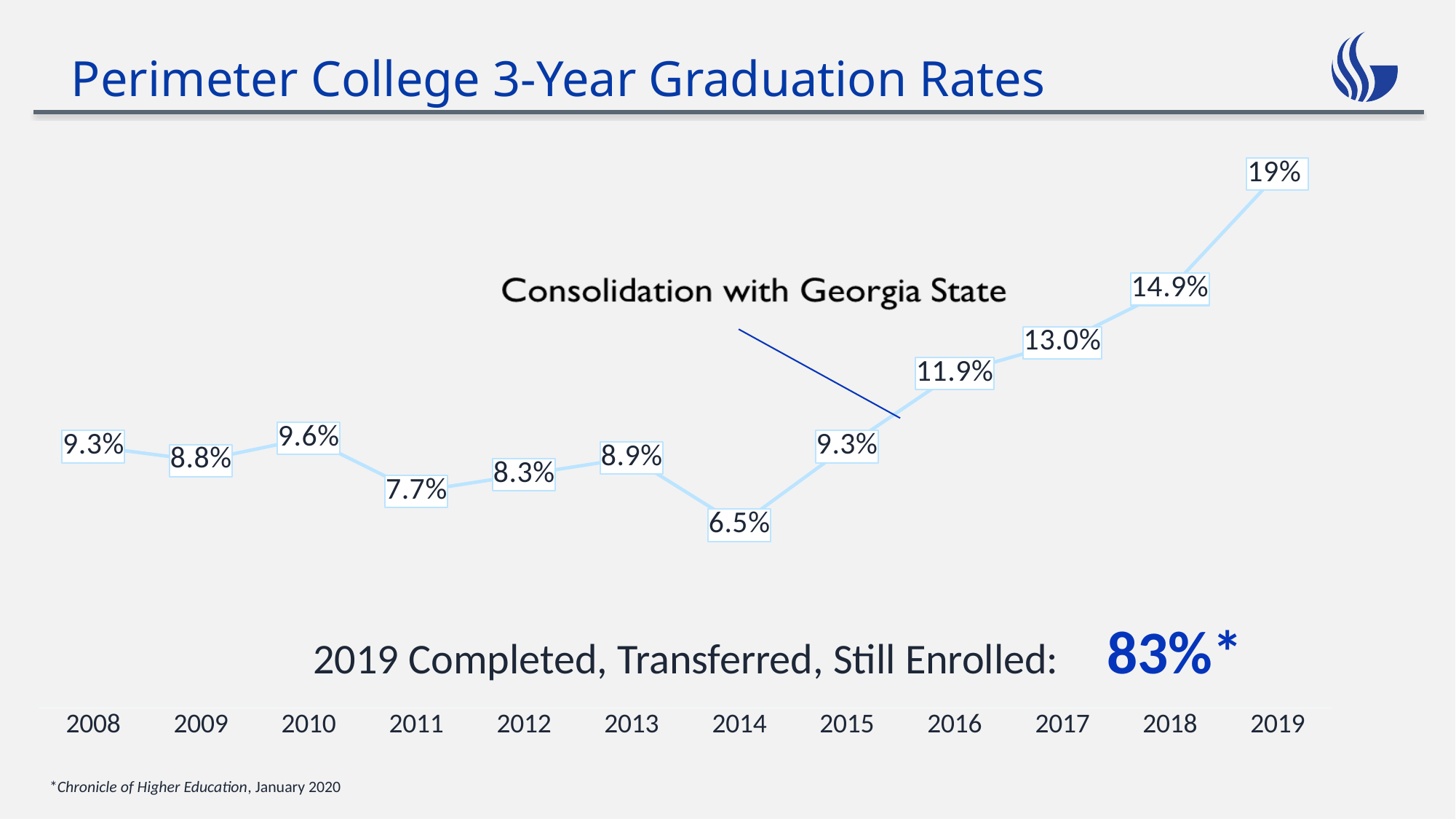
Which year has a higher graduation rate, 2010 or 2013? 2010 What is the difference between the 2016 and 2015 graduation rates? 2.6% How many years are plotted on the chart? 12 What is the 3-year graduation rate for 2014? 6.5% What is the difference between the 2019 and 2018 graduation rates? 4.1% What is the 3-year graduation rate for 2017? 13.0% What is the 3-year graduation rate for 2011? 7.7% Which year has the lowest 3-year graduation rate? 2014 Which year has the highest 3-year graduation rate? 2019 What is the 3-year graduation rate for 2019? 19% Do the graduation rates rise or fall from 2014 to 2019? Rise What kind of chart is shown on the slide? Line chart